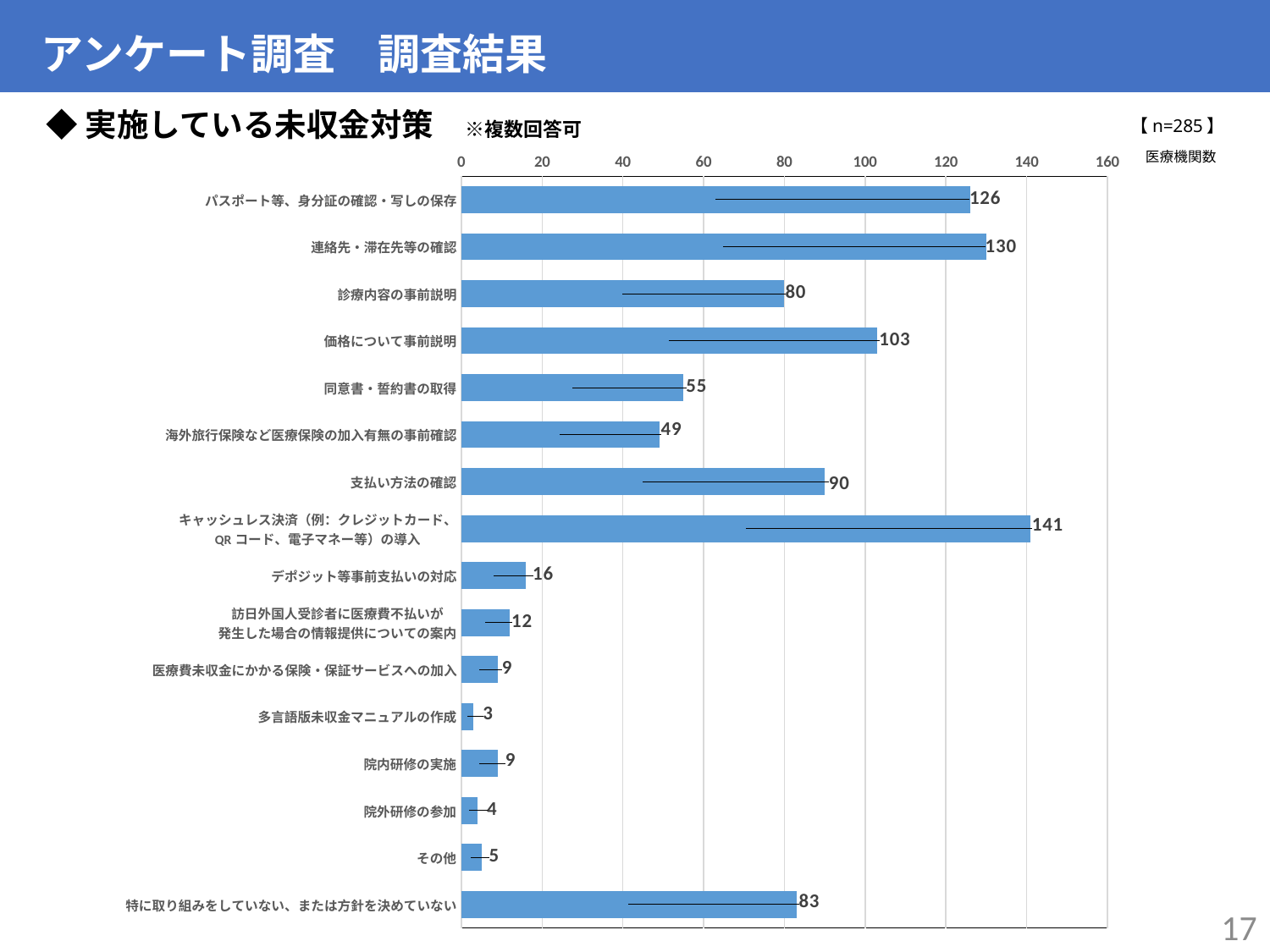
How many categories are shown in the chart? 16 What is the sample size (n) shown on the slide? n=285 Is the value for 価格について事前説明 greater or less than 100? greater What is the difference between the values for 価格について事前説明 and 診療内容の事前説明? 23 What kind of chart is shown on the slide? bar chart Which category has the lowest value? 多言語版未収金マニュアルの作成 What is the difference between the values for 連絡先・滞在先等の確認 and パスポート等、身分証の確認・写しの保存? 4 What is the value for 特に取り組みをしていない、または方針を決めていない? 83 Which category has the highest value? キャッシュレス決済（例：クレジットカード、QRコード、電子マネー等）の導入 What is the value for 支払い方法の確認? 90 What is the value for 連絡先・滞在先等の確認? 130 Which is larger, the value for 同意書・誓約書の取得 or the value for 海外旅行保険など医療保険の加入有無の事前確認? 同意書・誓約書の取得